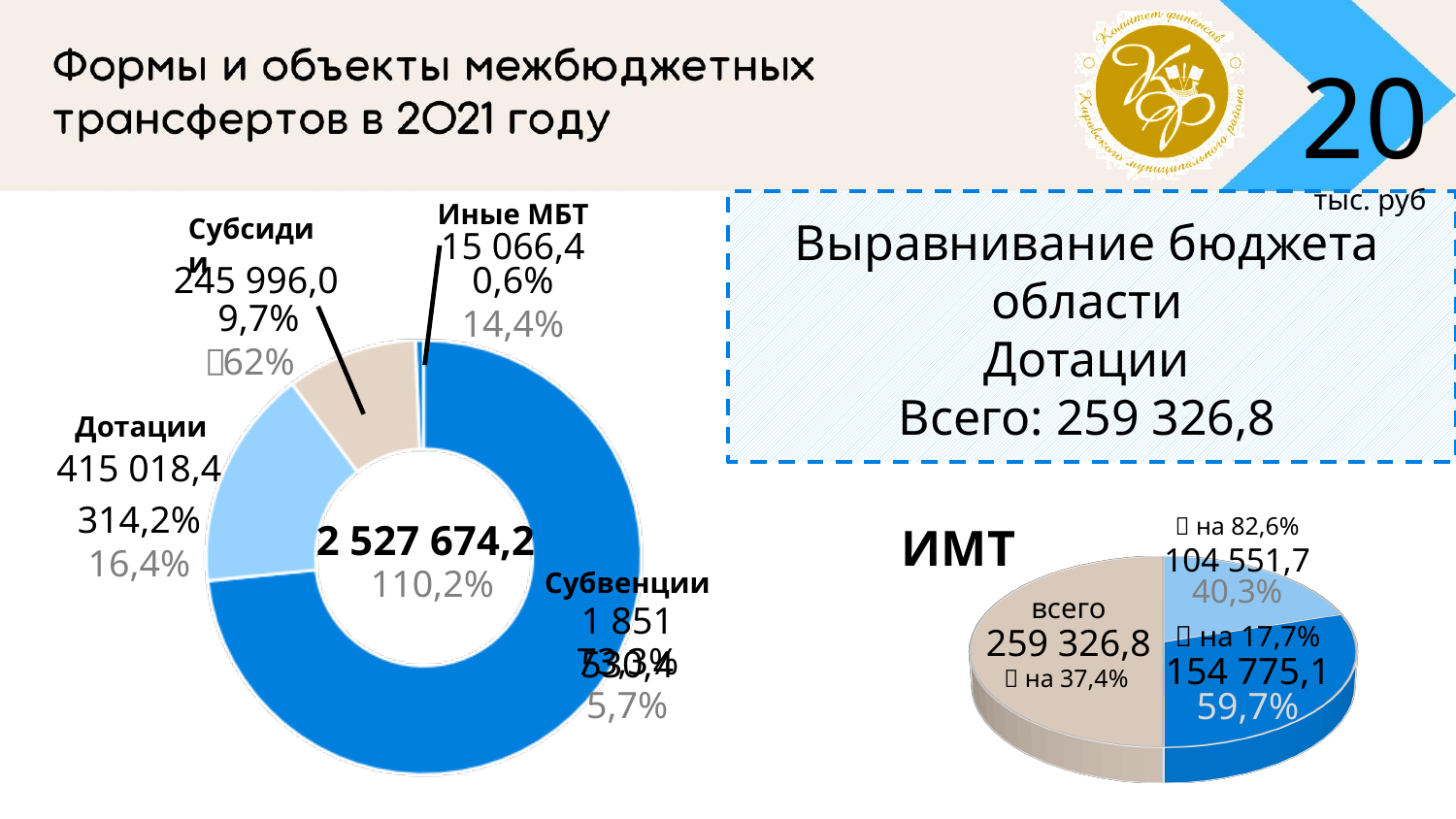
In the left doughnut chart, what is the value for Дотации? 415 018,4 In the left doughnut chart, what is the value for Иные МБТ? 15 066,4 In the left doughnut chart, what share of the total do Иные МБТ make up? 0,6% What total value is printed in the centre of the left doughnut chart? 2 527 674,2 In the left doughnut chart, what share of the total do Субсидии make up? 9,7% In the left doughnut chart, what is the value for Субсидии? 245 996,0 In the left doughnut chart, which category has the largest slice? Субвенции How many categories does the left doughnut chart show? 4 In the left doughnut chart, which category has the smallest slice? Иные МБТ In the ИМТ pie chart on the right, what is the share of the larger slice (154 775,1)? 59,7% In the left doughnut chart, what is the difference between the values for Дотации and Субсидии? 169 022,4 What kind of chart is the left chart showing the forms of interbudgetary transfers? doughnut chart